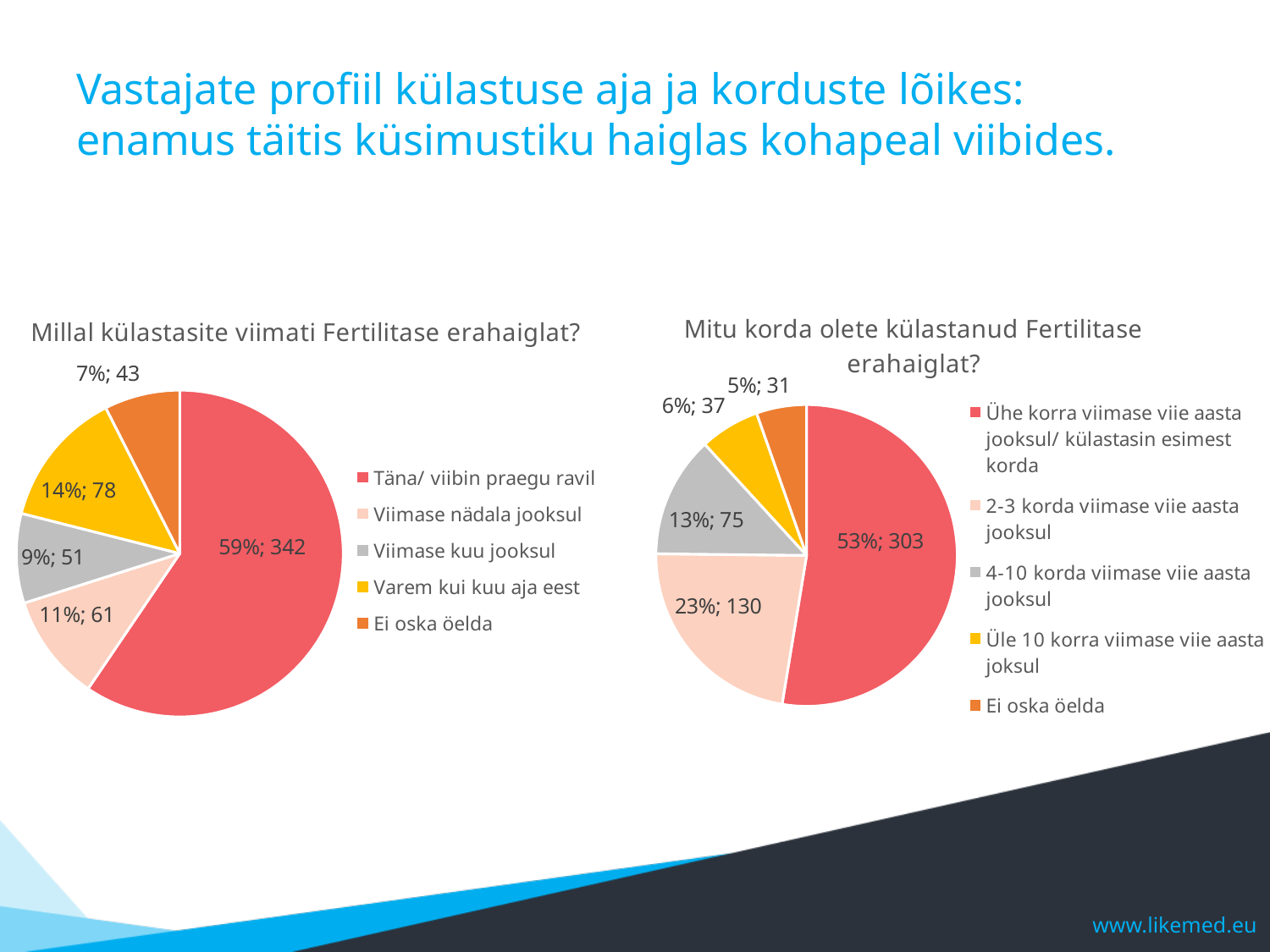
In the right chart 'Mitu korda olete külastanud Fertilitase erahaiglat?', which category has the largest slice? Ühe korra viimase viie aasta jooksul/ külastasin esimest korda In the right chart 'Mitu korda olete külastanud Fertilitase erahaiglat?', what colour is the slice for 'Ei oska öelda'? Orange In the right chart 'Mitu korda olete külastanud Fertilitase erahaiglat?', what share of the pie does 'Üle 10 korra viimase viie aasta joksul' have? 6% In the left chart 'Millal külastasite viimati Fertilitase erahaiglat?', what is the value shown for 'Varem kui kuu aja eest'? 14%; 78 In the left chart 'Millal külastasite viimati Fertilitase erahaiglat?', how many categories does the legend list? 5 In the right chart 'Mitu korda olete külastanud Fertilitase erahaiglat?', which is larger: '4-10 korda viimase viie aasta jooksul' or 'Ei oska öelda'? 4-10 korda viimase viie aasta jooksul In the left chart 'Millal külastasite viimati Fertilitase erahaiglat?', which category has the smallest slice? Ei oska öelda In the right chart 'Mitu korda olete külastanud Fertilitase erahaiglat?', what is the difference in count between 'Ühe korra viimase viie aasta jooksul/ külastasin esimest korda' and '2-3 korda viimase viie aasta jooksul'? 173 In the left chart 'Millal külastasite viimati Fertilitase erahaiglat?', what is the value shown for 'Täna/ viibin praegu ravil'? 59%; 342 In the right chart 'Mitu korda olete külastanud Fertilitase erahaiglat?', what is the value shown for '2-3 korda viimase viie aasta jooksul'? 23%; 130 In the left chart 'Millal külastasite viimati Fertilitase erahaiglat?', what is the difference in count between 'Viimase nädala jooksul' and 'Viimase kuu jooksul'? 10 What type of chart is the left chart 'Millal külastasite viimati Fertilitase erahaiglat?'? Pie chart